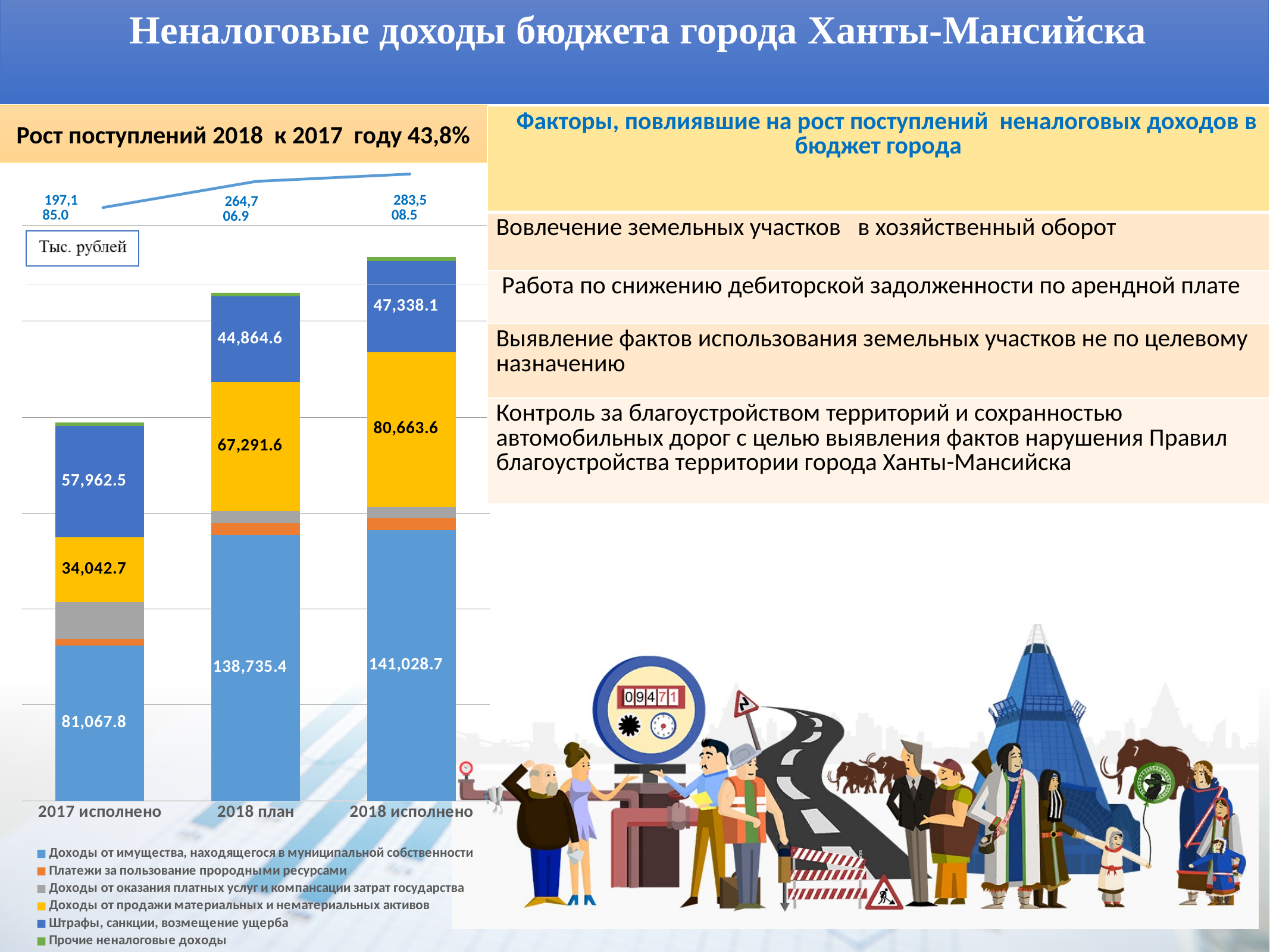
Which is larger: 'Штрафы, санкции, возмещение ущерба' for '2017 исполнено' or for '2018 исполнено'? 2017 исполнено How many categories are shown on the x axis of the bar chart? 3 How many series does the legend of the bar chart list? 6 What kind of chart is shown on the left side of the slide? stacked bar chart Do the values of 'Доходы от продажи материальных и нематериальных активов' rise or fall from '2017 исполнено' to '2018 исполнено'? rise What is the value of 'Штрафы, санкции, возмещение ущерба' for '2018 план'? 44,864.6 Which category has the lowest value for 'Штрафы, санкции, возмещение ущерба'? 2018 план Which category has the highest value for 'Доходы от имущества, находящегося в муниципальной собственности'? 2018 исполнено What unit is indicated in the box above the bar chart? Тыс. рублей What is the value of 'Доходы от имущества, находящегося в муниципальной собственности' for '2017 исполнено'? 81,067.8 What is the difference between 'Доходы от продажи материальных и нематериальных активов' for '2018 исполнено' and for '2017 исполнено'? 46,620.9 What is the value of 'Доходы от продажи материальных и нематериальных активов' for '2018 исполнено'? 80,663.6